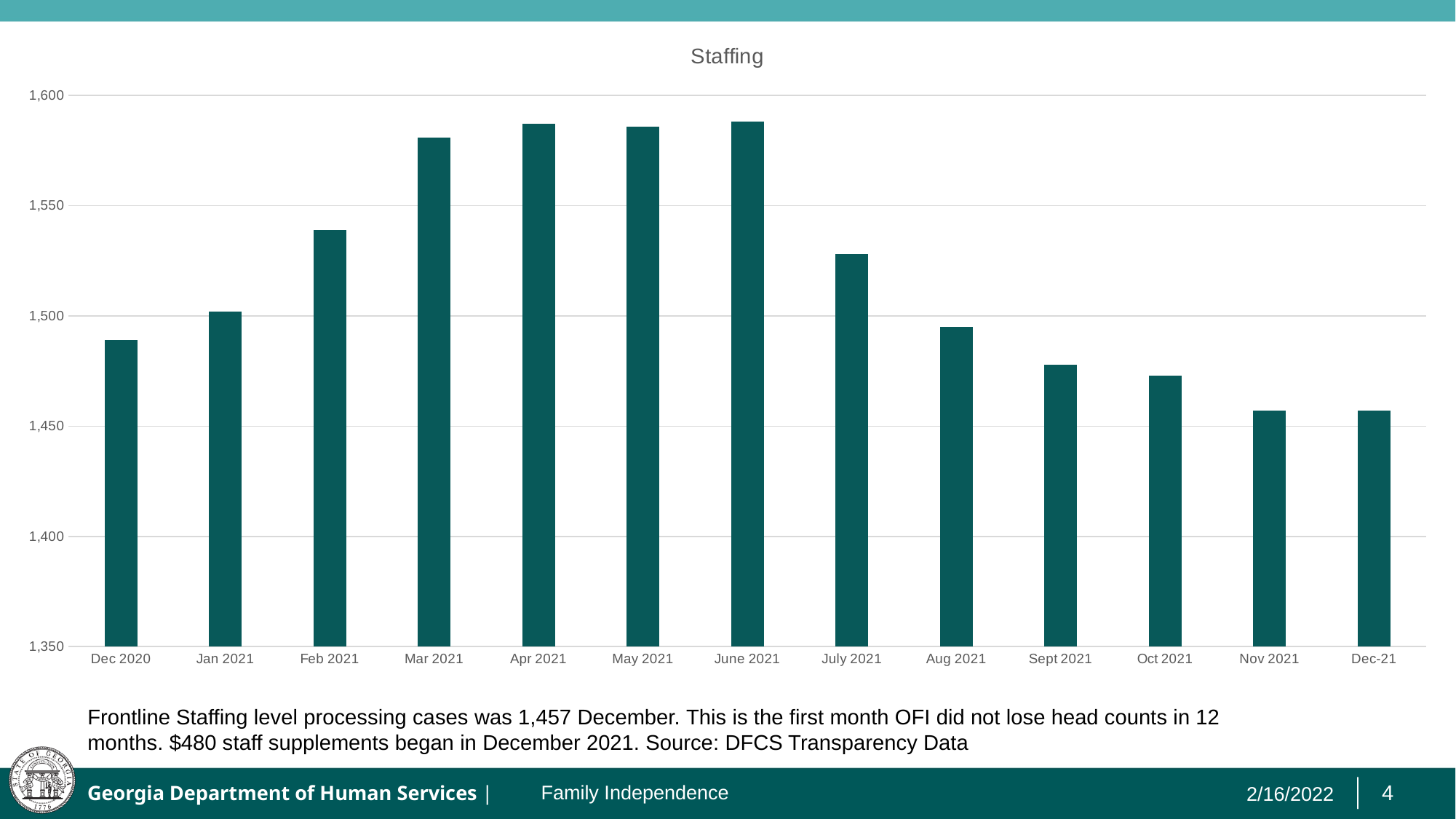
What is the title of the chart? Staffing What kind of chart is shown on the slide? bar chart Is the value for Sept 2021 greater or less than 1,500? less How many months are plotted on the x axis of the chart? 13 Which is larger, the value for July 2021 or the value for Aug 2021? July 2021 Do the values rise or fall from June 2021 to Nov 2021? fall According to the slide text, what was the frontline staffing level in December 2021? 1,457 Is the value for Dec 2020 greater or less than 1,500? less Is the value for Mar 2021 greater or less than 1,550? greater Which is larger, the value for Feb 2021 or the value for Mar 2021? Mar 2021